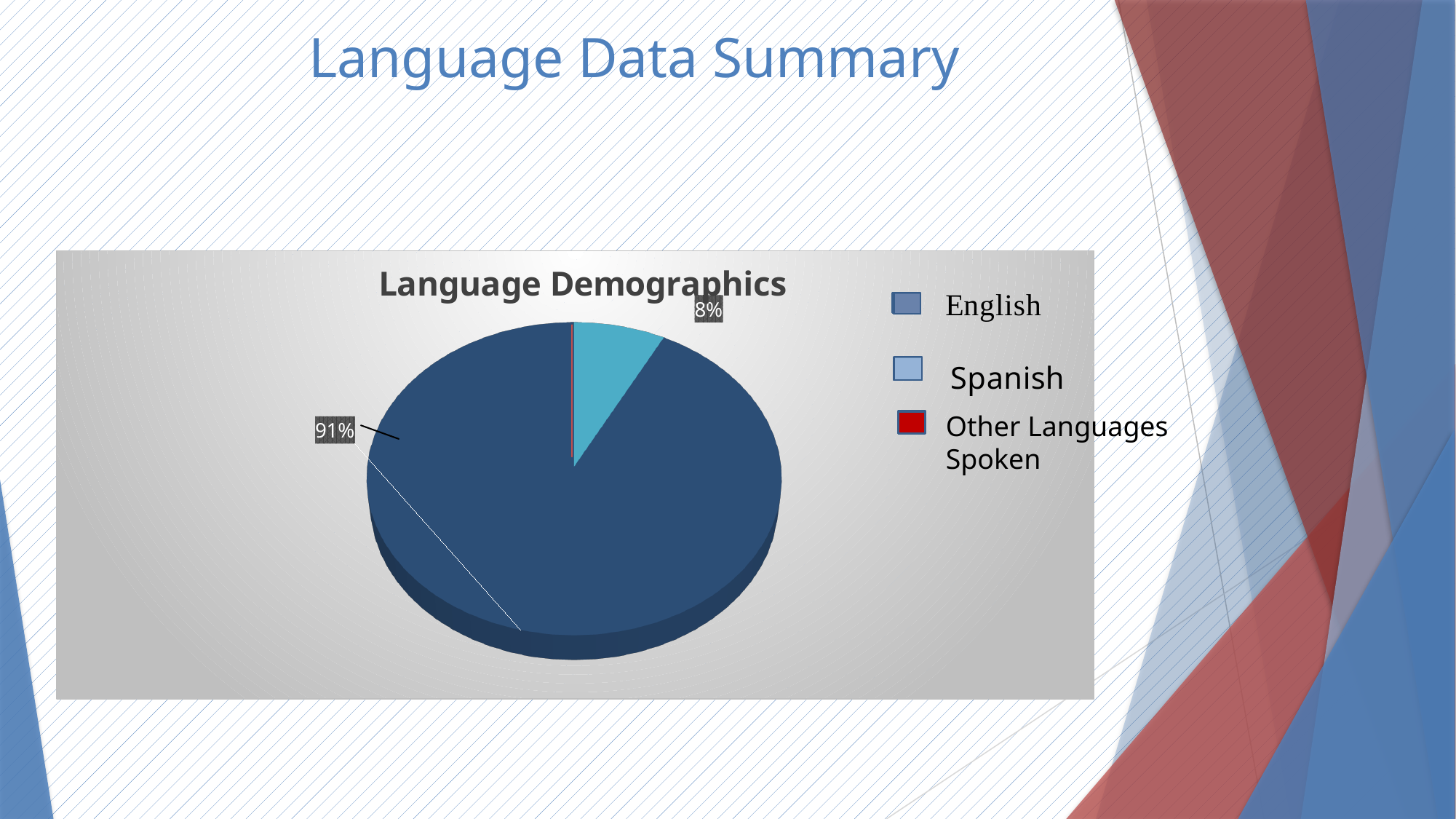
Which language has the largest slice in the Language Demographics pie chart? English What are the three legend entries of the Language Demographics chart? English, Spanish, Other Languages Spoken Is the Spanish share in the Language Demographics chart greater or less than 10%? less Which category has the smallest slice in the Language Demographics pie chart? Other Languages Spoken What kind of chart is shown on the slide? Pie chart By how many percentage points does the English share exceed the Spanish share in the Language Demographics chart? 83 percentage points Is the English share in the Language Demographics chart greater or less than 50%? greater How many categories does the Language Demographics chart's legend list? 3 What is the title of the chart on the slide? Language Demographics Which slice is larger in the Language Demographics chart, English or Spanish? English What percentage of the Language Demographics pie chart is Spanish? 8% What percentage of the Language Demographics pie chart is English? 91%